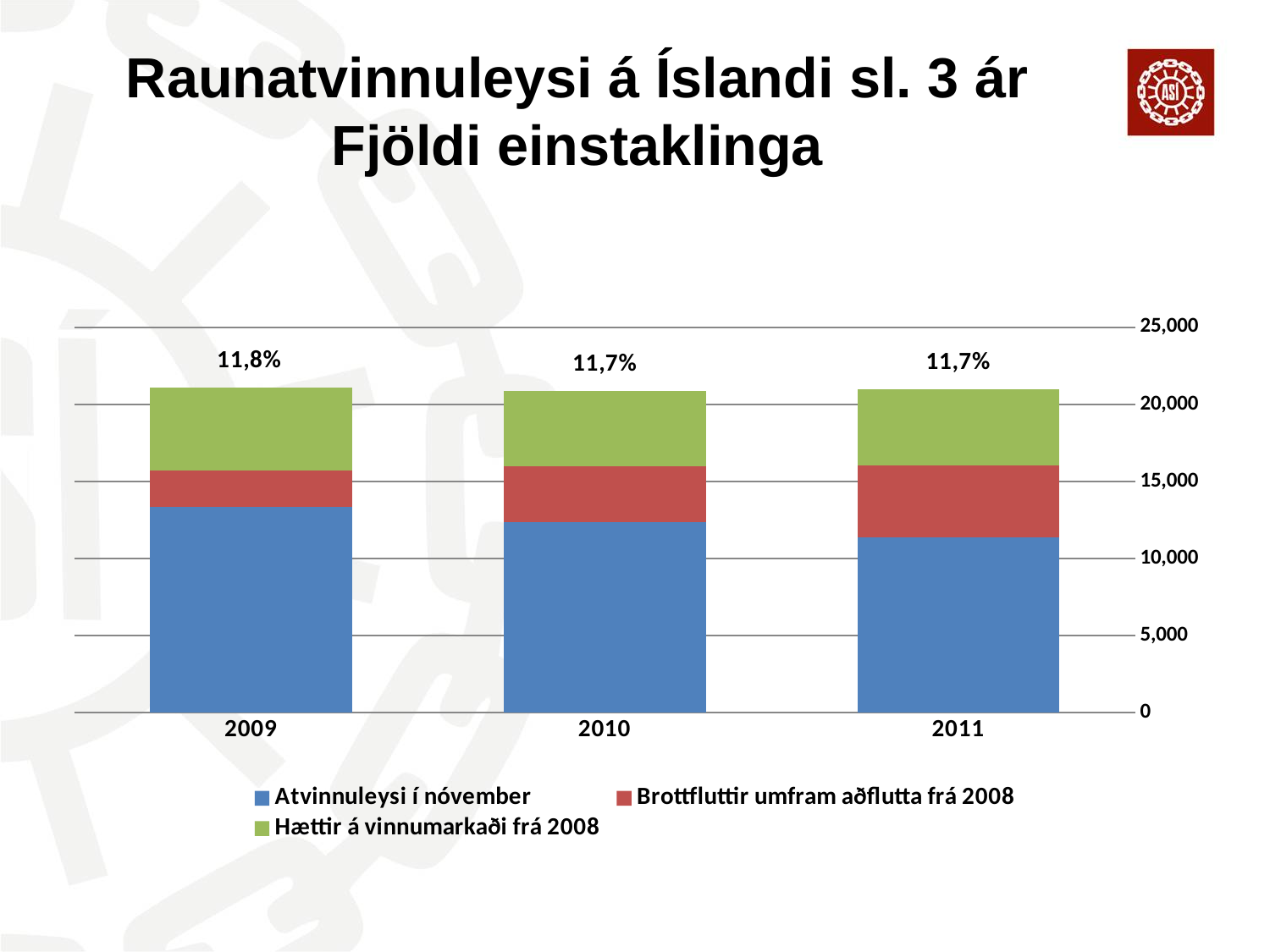
Is the value of the Atvinnuleysi í nóvember segment for 2009 greater or less than 10,000? greater What percentage label is printed above the 2009 bar? 11,8% How many years are shown on the x axis of the chart? 3 Is the total height of the 2009 stacked bar greater or less than 20,000? greater Which year has the highest percentage label above its bar? 2009 Is the value of the Atvinnuleysi í nóvember segment for 2010 greater or less than 15,000? less Which year has the larger Brottfluttir umfram aðflutta frá 2008 segment, 2009 or 2011? 2011 Does the Atvinnuleysi í nóvember segment rise or fall from 2009 to 2011? Fall How many series does the legend list? 3 What colour represents Hættir á vinnumarkaði frá 2008 in the chart? Green What kind of chart is shown on the slide? Stacked bar chart What percentage label is printed above the 2011 bar? 11,7%